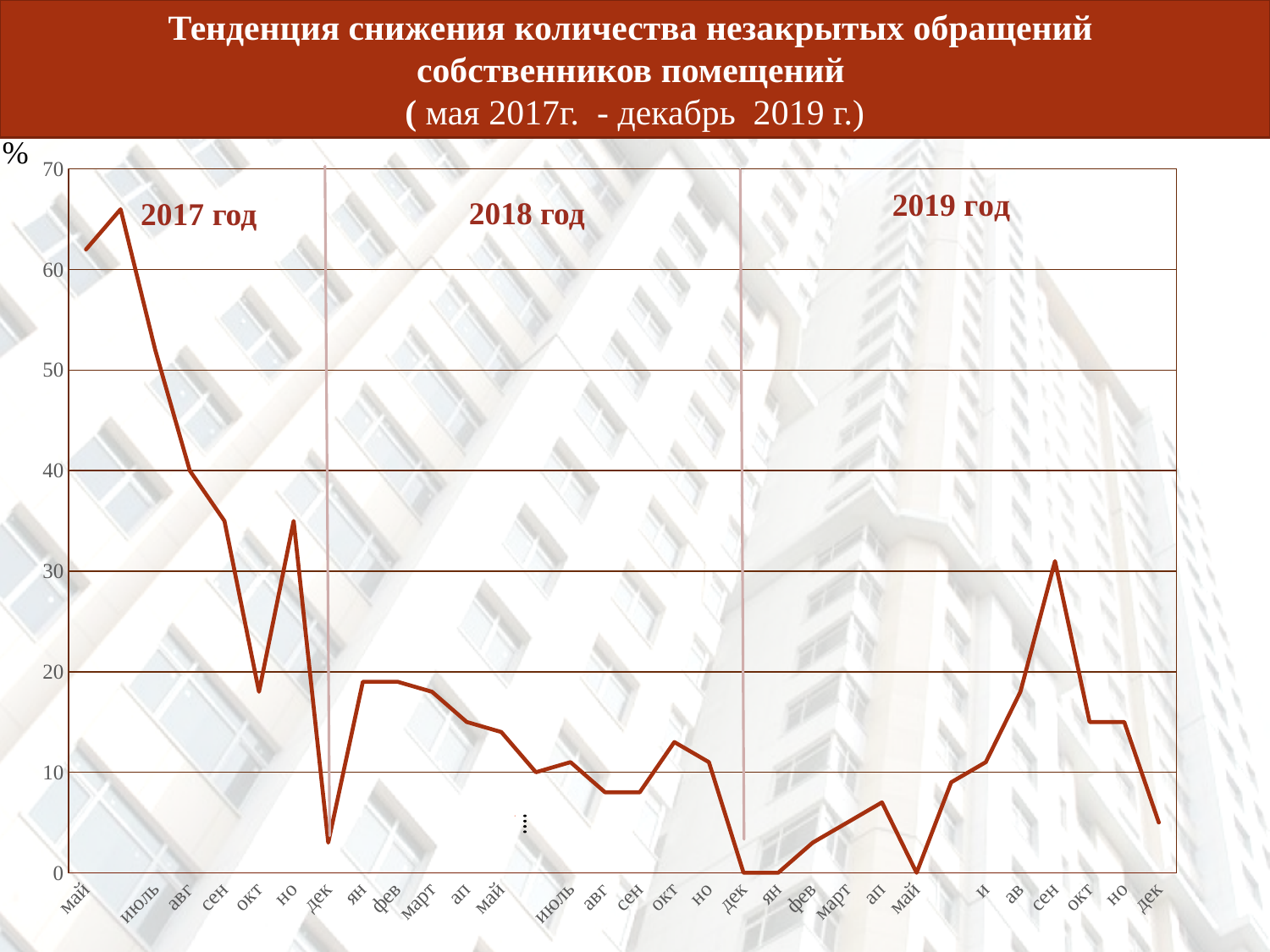
Is the value for сен 2019 greater or less than 20? greater In which year section does the line reach its highest value? 2017 год What unit is shown on the vertical axis of the chart? % Is the value for дек 2019 greater or less than 10? less How many year sections (2017 год, 2018 год, 2019 год) is the chart divided into? 3 Which is larger: the value for май 2017 or the value for дек 2019? май 2017 What kind of chart is shown on the slide? line chart What is the maximum value shown on the vertical axis? 70 Is the value for май 2017 greater or less than 60? greater How many data series (lines) are plotted on the chart? 1